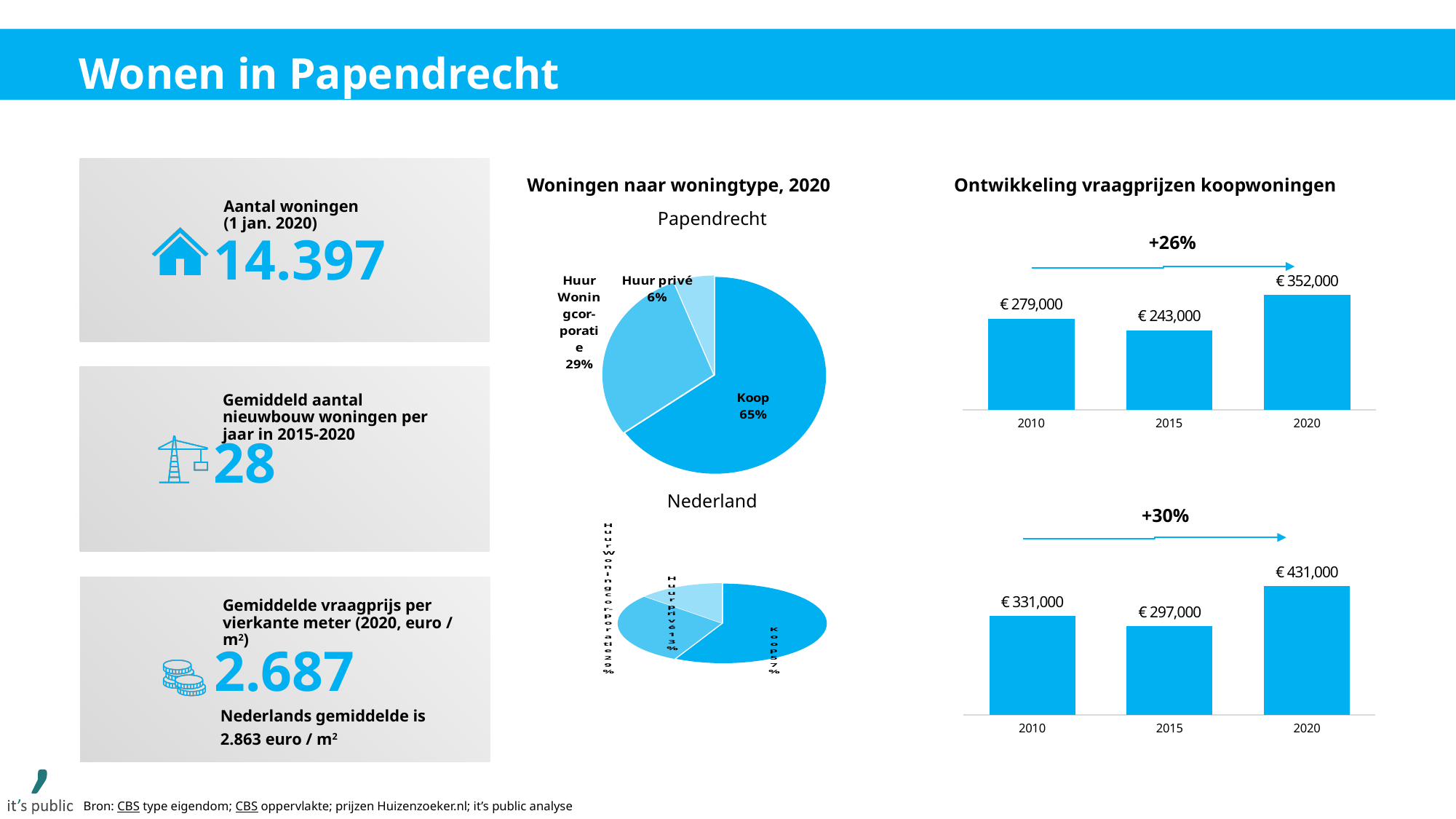
In the Papendrecht pie chart under 'Woningen naar woningtype, 2020', which category has the largest slice? Koop In the Papendrecht pie chart under 'Woningen naar woningtype, 2020', how many slices are there? 3 What kind of chart is used under 'Ontwikkeling vraagprijzen koopwoningen'? Bar chart In the upper bar chart under 'Ontwikkeling vraagprijzen koopwoningen', what is the value for 2020? € 352,000 In the lower bar chart under 'Ontwikkeling vraagprijzen koopwoningen', what is the value for 2010? € 331,000 In the upper bar chart under 'Ontwikkeling vraagprijzen koopwoningen', which year has the lowest value? 2015 In the upper bar chart under 'Ontwikkeling vraagprijzen koopwoningen', what is the value for 2015? € 243,000 In the Papendrecht pie chart under 'Woningen naar woningtype, 2020', what share is Koop? 65% In the Papendrecht pie chart under 'Woningen naar woningtype, 2020', what share is Huur Woningcorporatie? 29% In the Papendrecht pie chart under 'Woningen naar woningtype, 2020', what share is Huur privé? 6% In the lower bar chart under 'Ontwikkeling vraagprijzen koopwoningen', which year has the highest value? 2020 In the upper bar chart under 'Ontwikkeling vraagprijzen koopwoningen', what is the difference between the 2020 and 2010 values? € 73,000